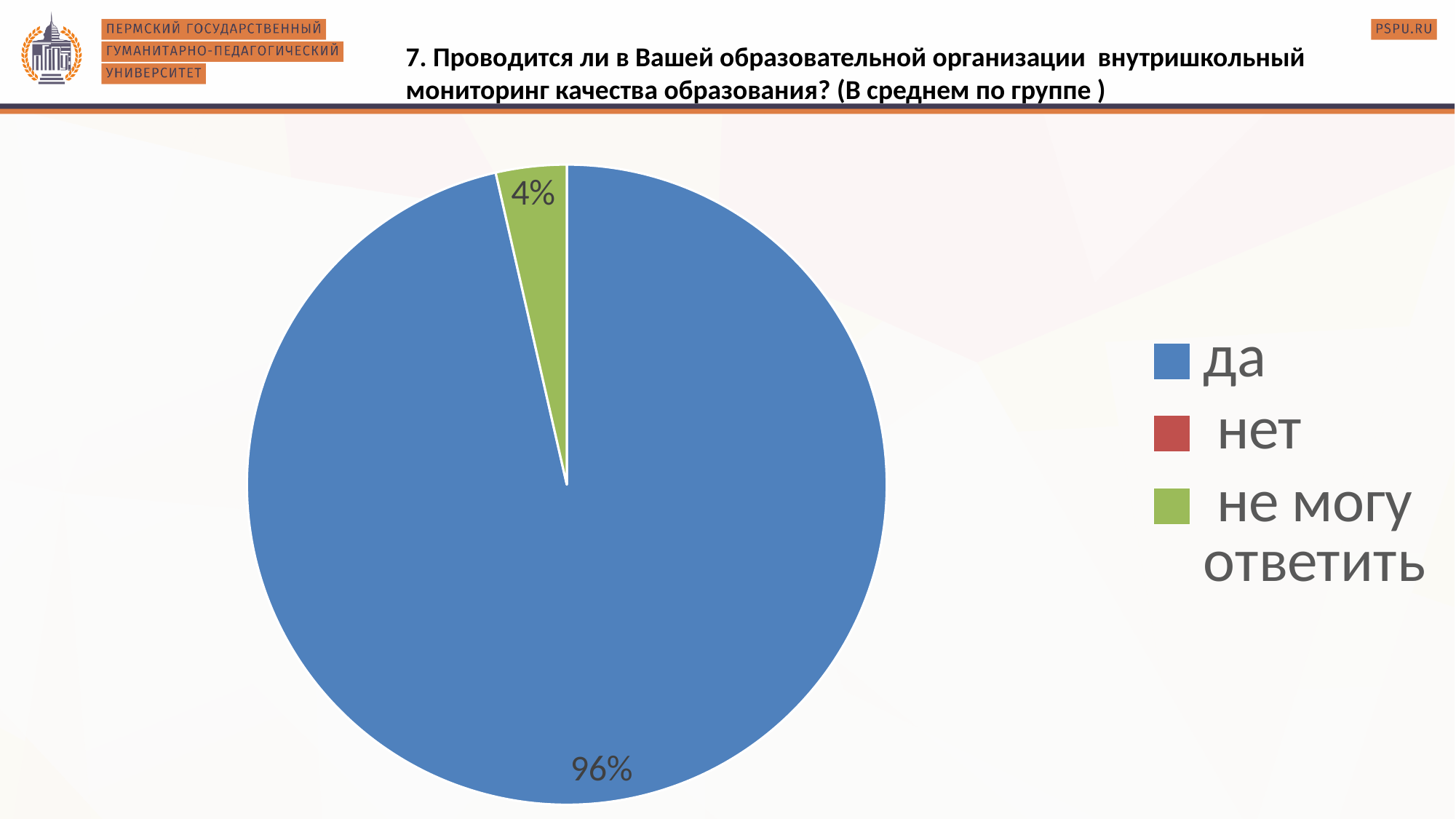
Is the share for "не могу ответить" greater or less than 10%? less Is the share for "да" greater or less than 50%? greater Which legend entry is shown in green? не могу ответить Which category has the largest slice of the pie? да What is the difference in percentage points between the "да" slice and the "не могу ответить" slice? 92 Which of the two labelled slices is larger, "да" or "не могу ответить"? да What colour is the "да" slice in the pie chart? blue What kind of chart is shown on the slide? pie chart What share of the pie does the "не могу ответить" slice take? 4% How many entries does the legend list? 3 What share of the pie does the "да" slice take? 96%